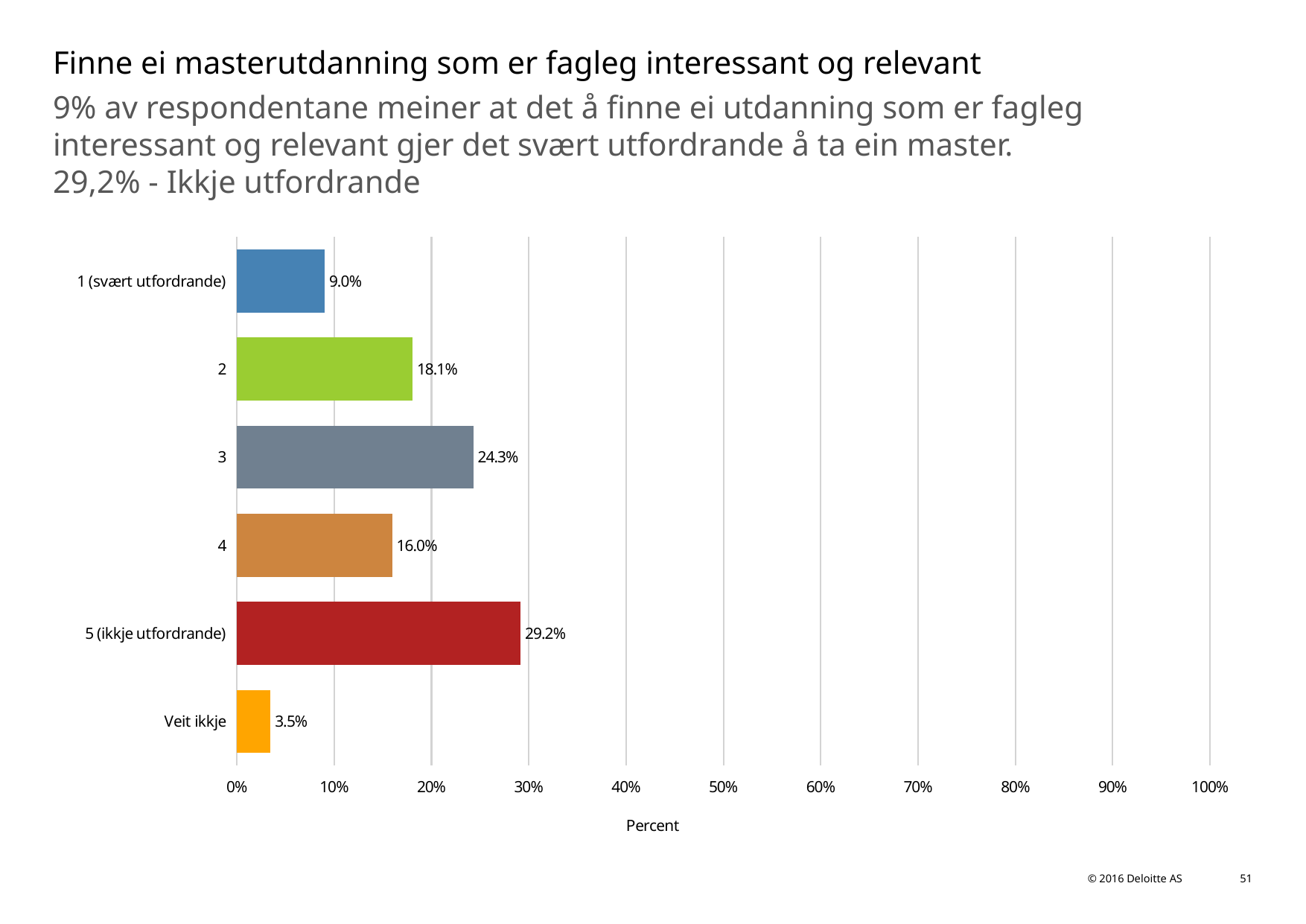
Which is larger, the value for category "3" or the value for category "2"? 3 Which category has the lowest value? Veit ikkje How many categories are shown in the chart? 6 What is the value for "Veit ikkje"? 3.5% What is the difference between the values for "5 (ikkje utfordrande)" and "1 (svært utfordrande)"? 20.2% What is the label of the horizontal axis? Percent What is the value for "1 (svært utfordrande)"? 9.0% What is the value for category "3"? 24.3% Is the value for category "4" greater or less than 20%? less Which category has the highest value? 5 (ikkje utfordrande) What kind of chart is shown on the slide? bar chart What is the difference between the values for category "2" and category "4"? 2.1%